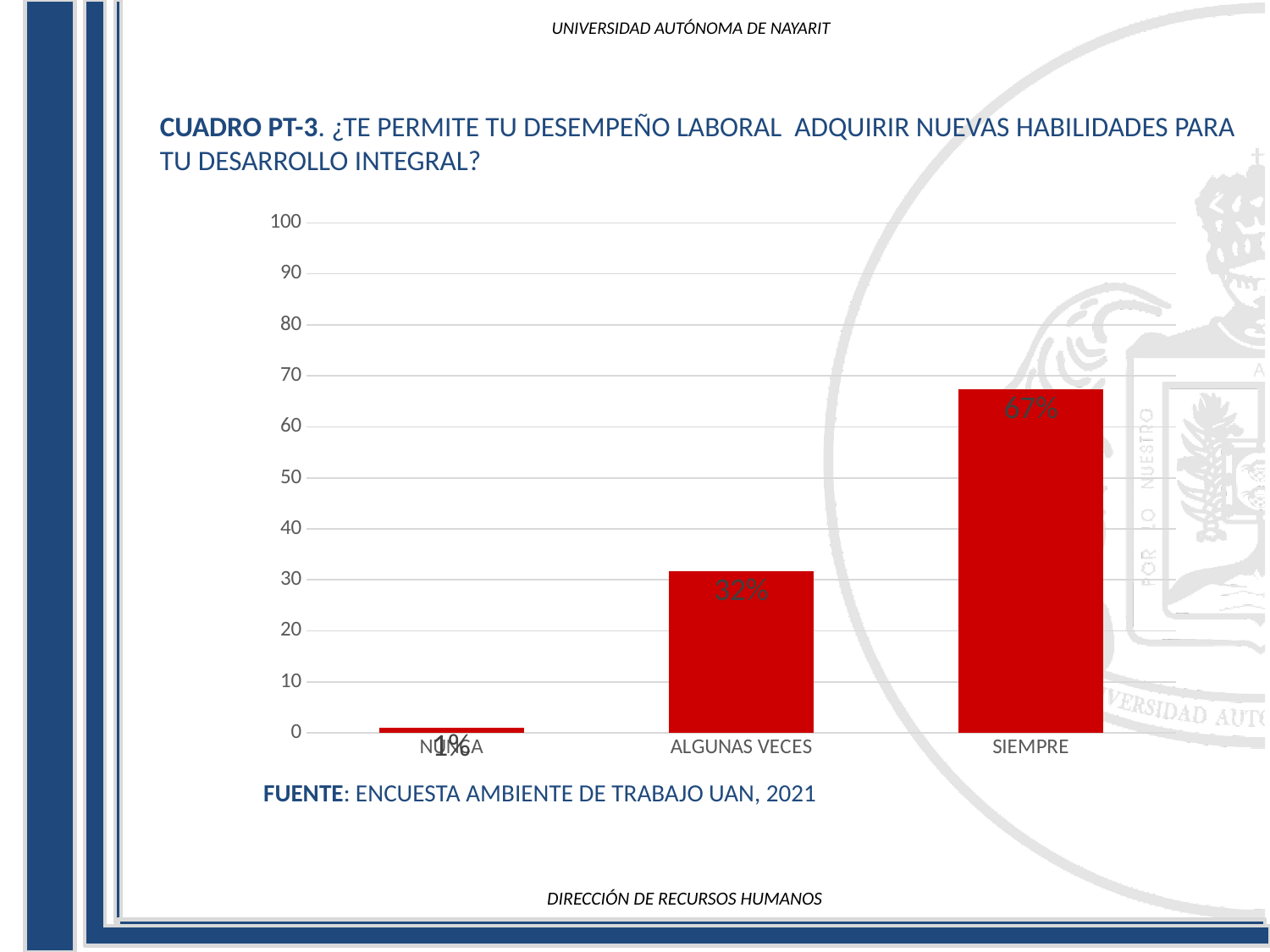
What is the value for NUNCA? 1% What is the difference between the values for SIEMPRE and ALGUNAS VECES? 35% What is the value for SIEMPRE? 67% What source is cited below the chart? ENCUESTA AMBIENTE DE TRABAJO UAN, 2021 What is the value for ALGUNAS VECES? 32% Which category has the highest value? SIEMPRE Do the values rise or fall from left to right along the x axis? rise Which is larger, the value for ALGUNAS VECES or the value for NUNCA? ALGUNAS VECES Which category has the lowest value? NUNCA What kind of chart is shown on the slide? bar chart How many categories are shown on the x axis of the chart? 3 Is the value for SIEMPRE greater or less than 60? greater